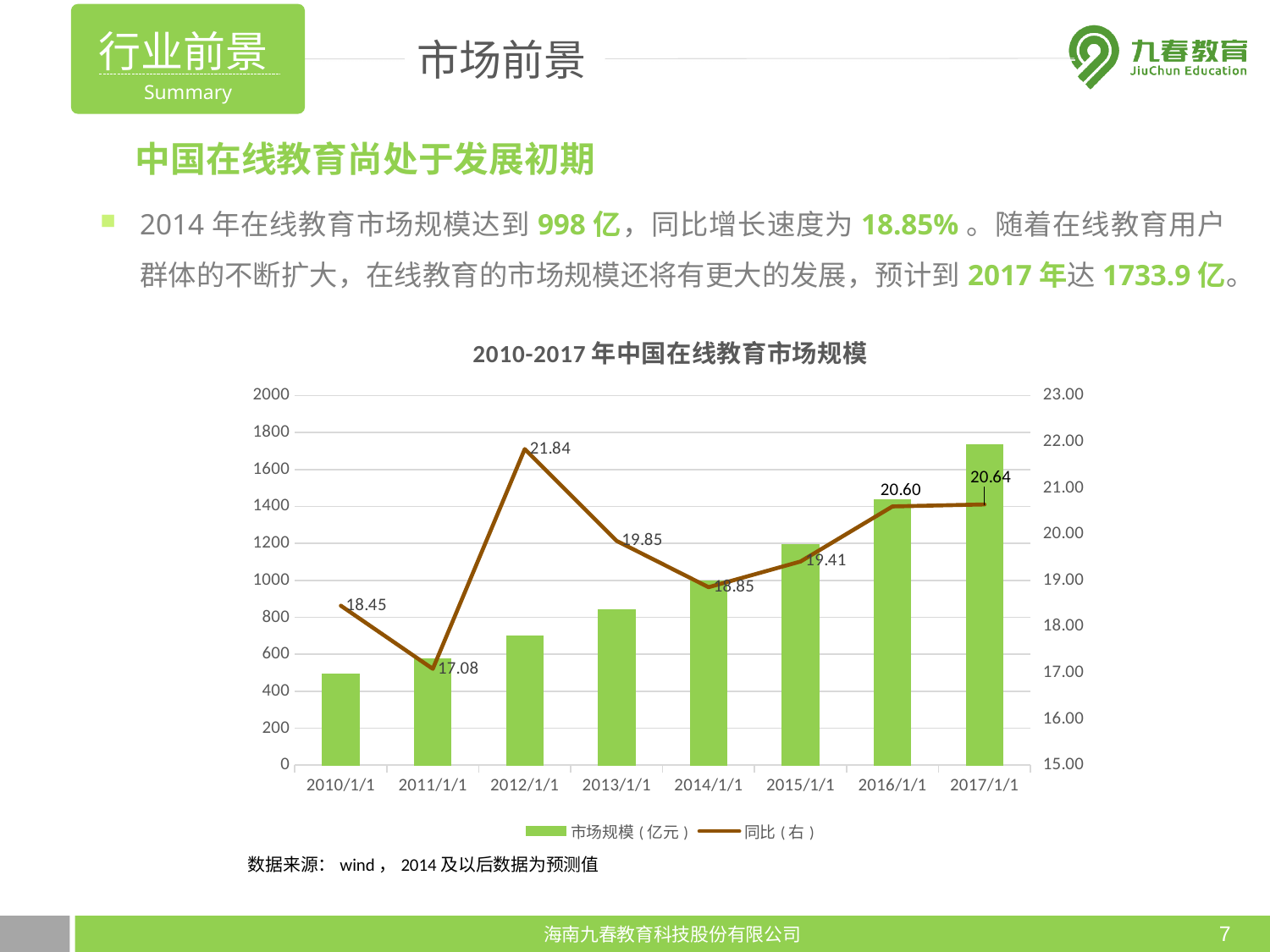
What is the 同比 (right axis) value for 2012/1/1? 21.84 What is the 同比 (right axis) value for 2014/1/1? 18.85 Which year has the highest 同比 value? 2012/1/1 Do the 市场规模 bars rise or fall from 2010/1/1 to 2017/1/1? rise What is the difference between the 同比 values for 2012/1/1 and 2011/1/1? 4.76 What is the 同比 (right axis) value for 2011/1/1? 17.08 How many years are shown on the x axis of the chart? 8 Which year has the lowest 同比 value? 2011/1/1 Which has a larger 同比 value, 2013/1/1 or 2015/1/1? 2013/1/1 How many series does the chart legend list? 2 Is the 市场规模 bar for 2010/1/1 greater or less than 600? less Is the 市场规模 bar for 2017/1/1 greater or less than 1600? greater